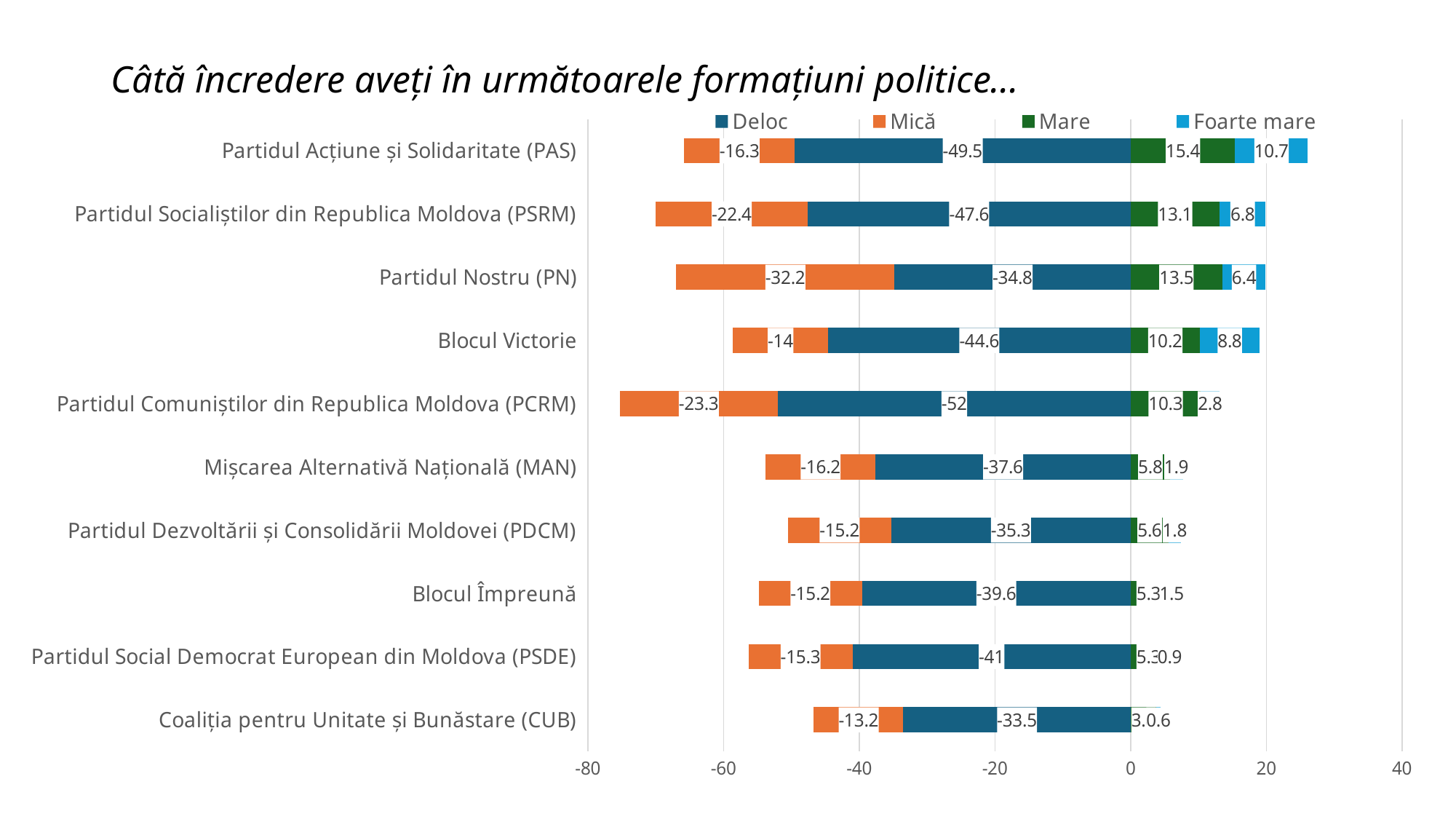
What is the difference between the 'Foarte mare' values of PAS (10.7) and PSRM (6.8)? 3.9 Which has the larger 'Mică' bar in absolute terms, Partidul Nostru (PN) or PSRM? Partidul Nostru (PN) What kind of chart is shown on the slide? bar chart What is the 'Deloc' value for Partidul Acțiune și Solidaritate (PAS)? -49.5 Which political formation has the lowest (most negative) 'Deloc' value? Partidul Comuniștilor din Republica Moldova (PCRM) What are the four legend entries of the chart? Deloc, Mică, Mare, Foarte mare What is the 'Foarte mare' value for Blocul Victorie? 8.8 Which political formation has the highest 'Mare' value? Partidul Acțiune și Solidaritate (PAS) What is the 'Mică' value for Partidul Socialiștilor din Republica Moldova (PSRM)? -22.4 What is the 'Mare' value for Partidul Nostru (PN)? 13.5 How many political formations (categories) are plotted in the chart? 10 How many series does the legend list? 4